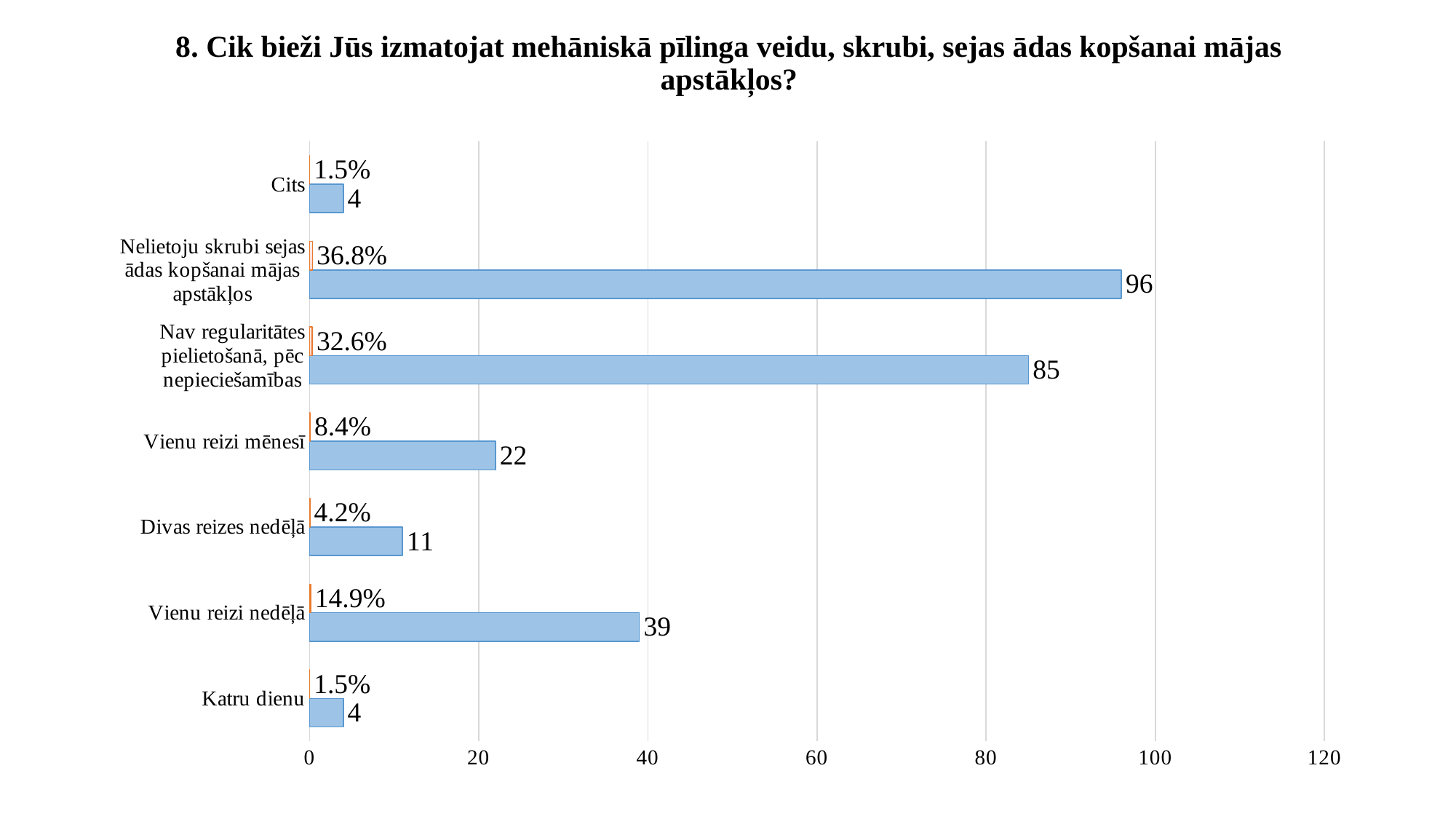
What is the count value for "Divas reizes nedēļā"? 11 What is the difference between the counts for "Nelietoju skrubi sejas ādas kopšanai mājas apstākļos" and "Nav regularitātes pielietošanā, pēc nepieciešamības"? 11 What is the count value for "Katru dienu"? 4 What kind of chart is shown on the slide? bar chart What percentage is shown for "Nav regularitātes pielietošanā, pēc nepieciešamības"? 32.6% How many categories are shown on the chart? 7 What is the count value for "Vienu reizi nedēļā"? 39 What is the highest value shown on the x axis? 120 Which has a larger count, "Vienu reizi nedēļā" or "Vienu reizi mēnesī"? Vienu reizi nedēļā Which category has the highest count? Nelietoju skrubi sejas ādas kopšanai mājas apstākļos What is the difference between the counts for "Vienu reizi nedēļā" and "Divas reizes nedēļā"? 28 What percentage is shown for "Vienu reizi mēnesī"? 8.4%